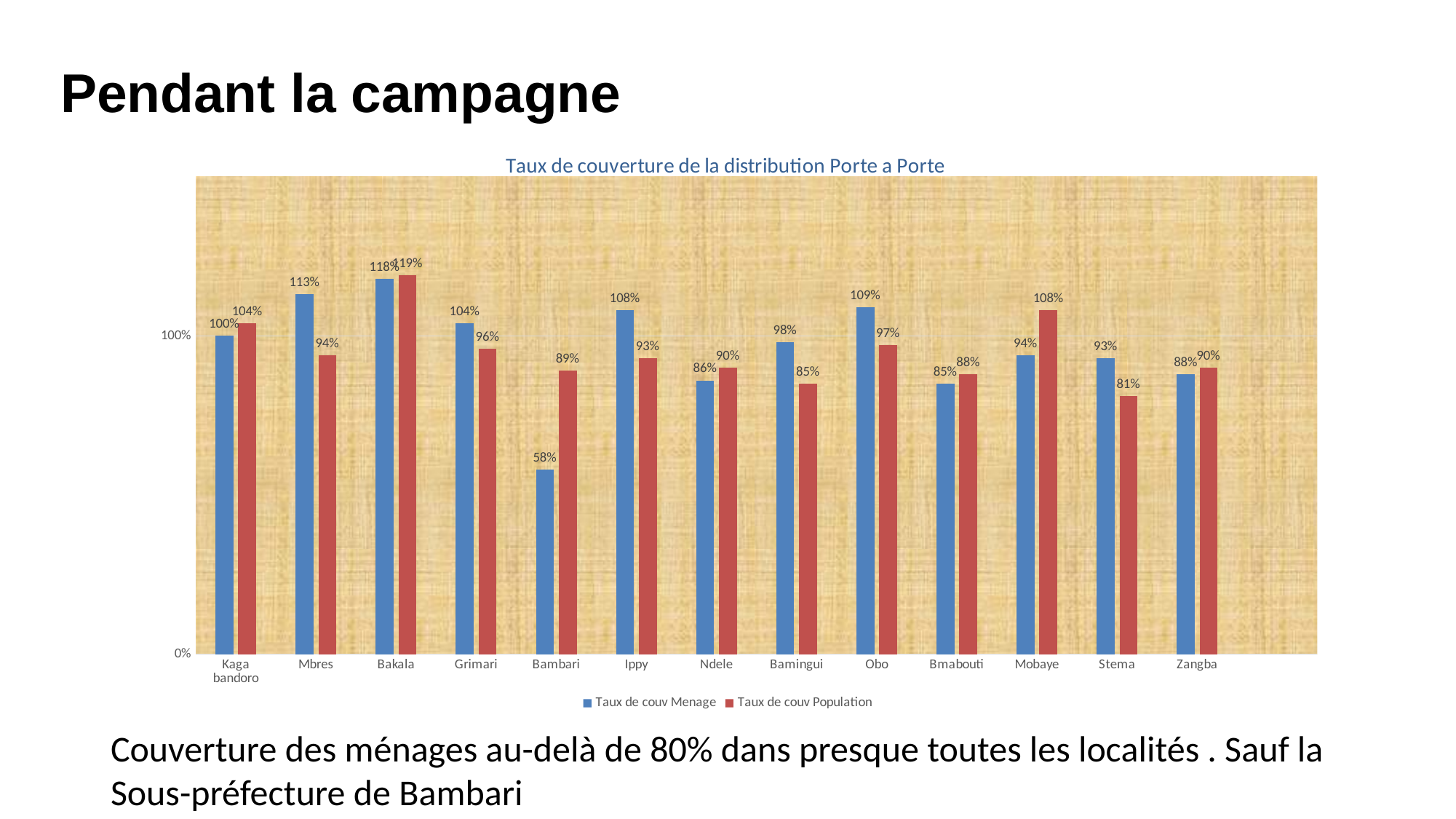
What kind of chart is shown on the slide? Bar chart For Obo, which is larger: Taux de couv Menage or Taux de couv Population? Taux de couv Menage What is the difference between the Taux de couv Population and the Taux de couv Menage for Bambari? 31% Which locality has the lowest Taux de couv Population? Stema How many localities are shown on the x axis? 13 What is the Taux de couv Population value for Mobaye? 108% Is the Taux de couv Menage value for Bambari greater or less than 100%? less Which locality has the highest Taux de couv Population? Bakala Which locality has the lowest Taux de couv Menage? Bambari What is the Taux de couv Menage value for Mbres? 113% What is the title of the chart? Taux de couverture de la distribution Porte a Porte How many series does the legend list? 2